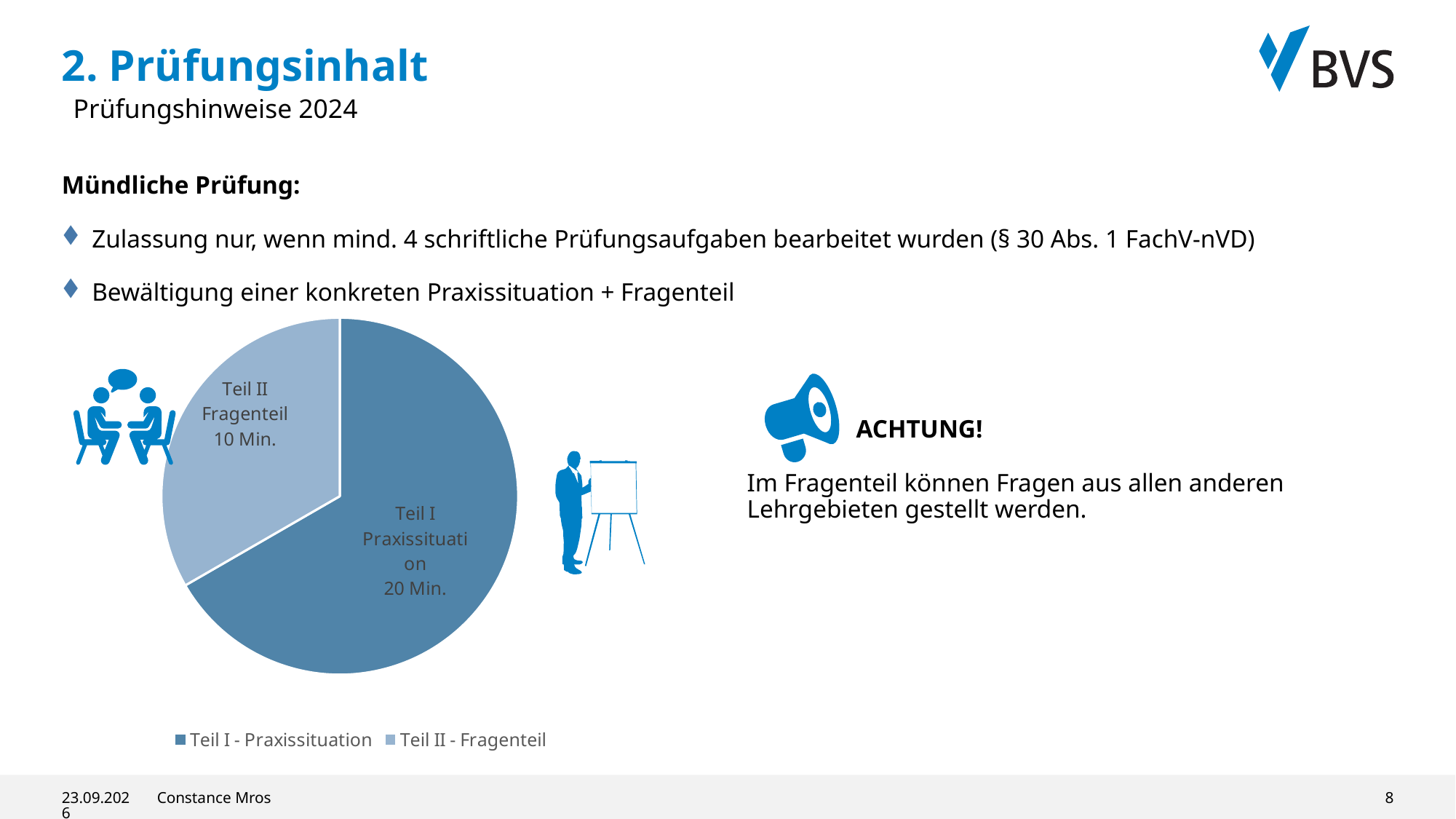
How many entries does the legend of the pie chart list? 2 Which slice of the pie chart is the smallest? Teil II - Fragenteil How many slices does the pie chart have? 2 Which slice of the pie chart is the largest? Teil I - Praxissituation What are the two legend entries of the pie chart? Teil I - Praxissituation; Teil II - Fragenteil What share of the pie does Teil II Fragenteil represent? one third Which is larger, Teil I Praxissituation or Teil II Fragenteil? Teil I Praxissituation How many minutes are shown for Teil I Praxissituation in the pie chart? 20 Min. How many minutes are shown for Teil II Fragenteil in the pie chart? 10 Min. What kind of chart is shown on the slide? pie chart What is the total number of minutes across both slices of the pie chart? 30 Min. What is the difference in minutes between Teil I Praxissituation and Teil II Fragenteil? 10 Min.